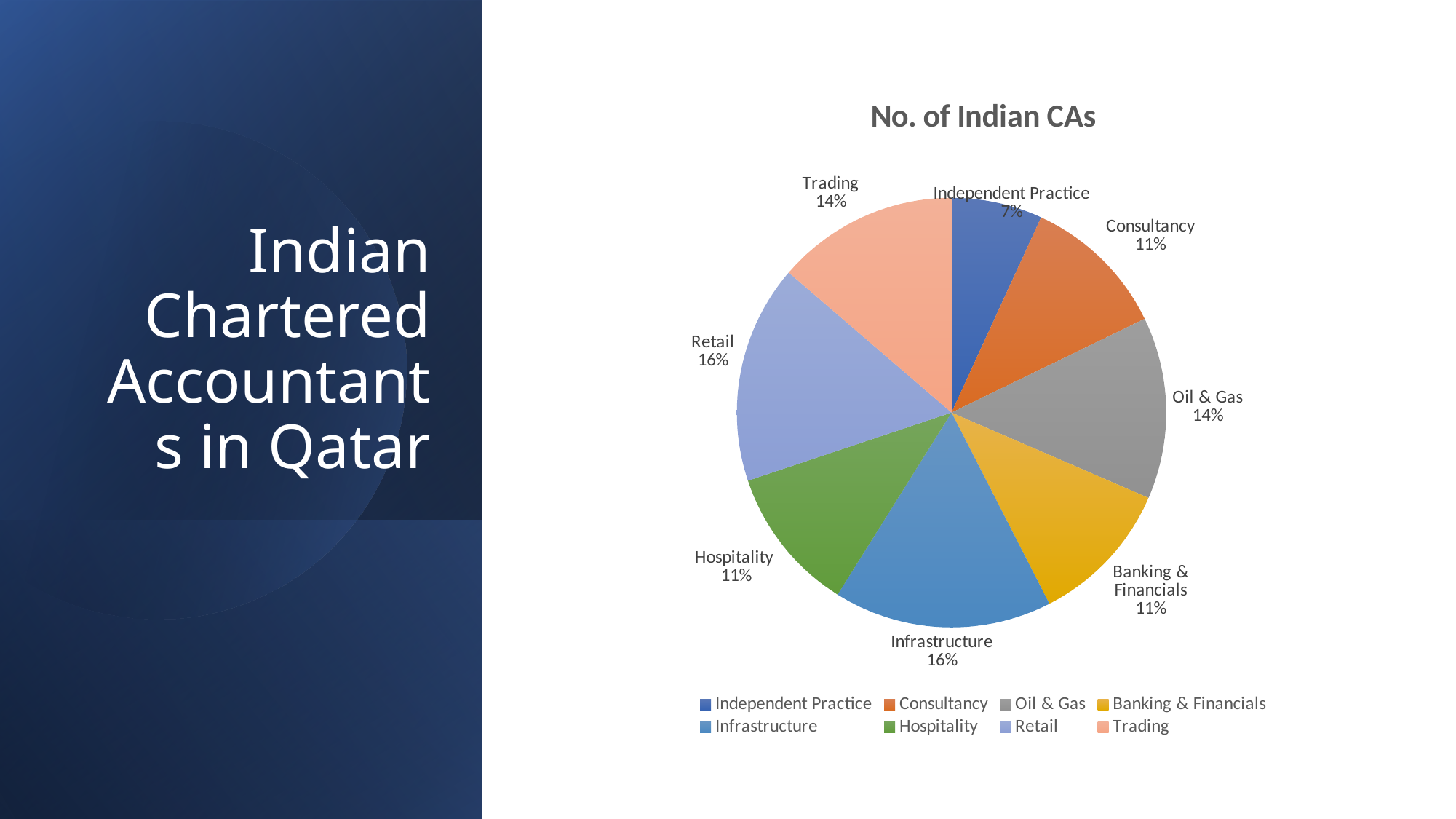
Which category has the smallest slice of the pie? Independent Practice How many categories are shown in the pie chart? 8 What is the difference in percentage points between Retail and Consultancy? 5 What share of the pie does Independent Practice represent? 7% What percentage is shown for Banking & Financials? 11% What is the title of the chart? No. of Indian CAs What is the difference in percentage points between Oil & Gas and Independent Practice? 7 Which is larger, the share for Trading or the share for Hospitality? Trading How many entries does the legend list? 8 What percentage is shown for Oil & Gas? 14% What kind of chart is shown on the slide? Pie chart What percentage is shown for Infrastructure? 16%